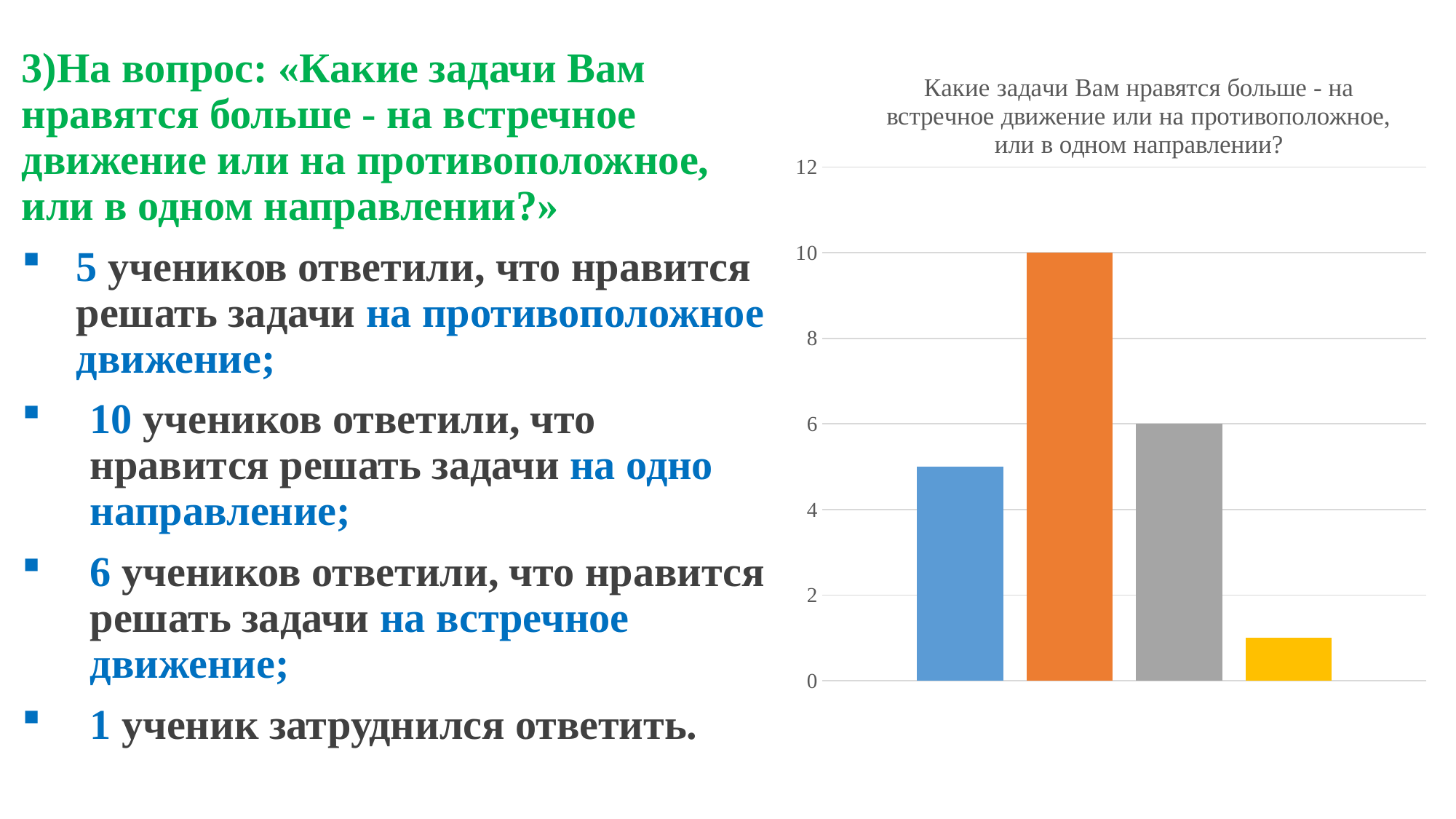
What kind of chart is shown on the slide? bar chart Is the value of the blue (first) bar greater or less than 4? greater Is the value of the yellow (fourth) bar greater or less than 2? less Which is larger, the blue (first) bar or the gray (third) bar? the gray (third) bar What colour is the tallest bar in the chart? orange What value does the orange (second) bar reach? 10 Which bar is the tallest in the chart? the second (orange) bar How many bars are plotted in the chart? 4 What is the highest value shown on the vertical axis of the chart? 12 What is the difference between the orange bar and the gray bar? 4 What value does the gray (third) bar reach? 6 Which bar is the shortest in the chart? the fourth (yellow) bar